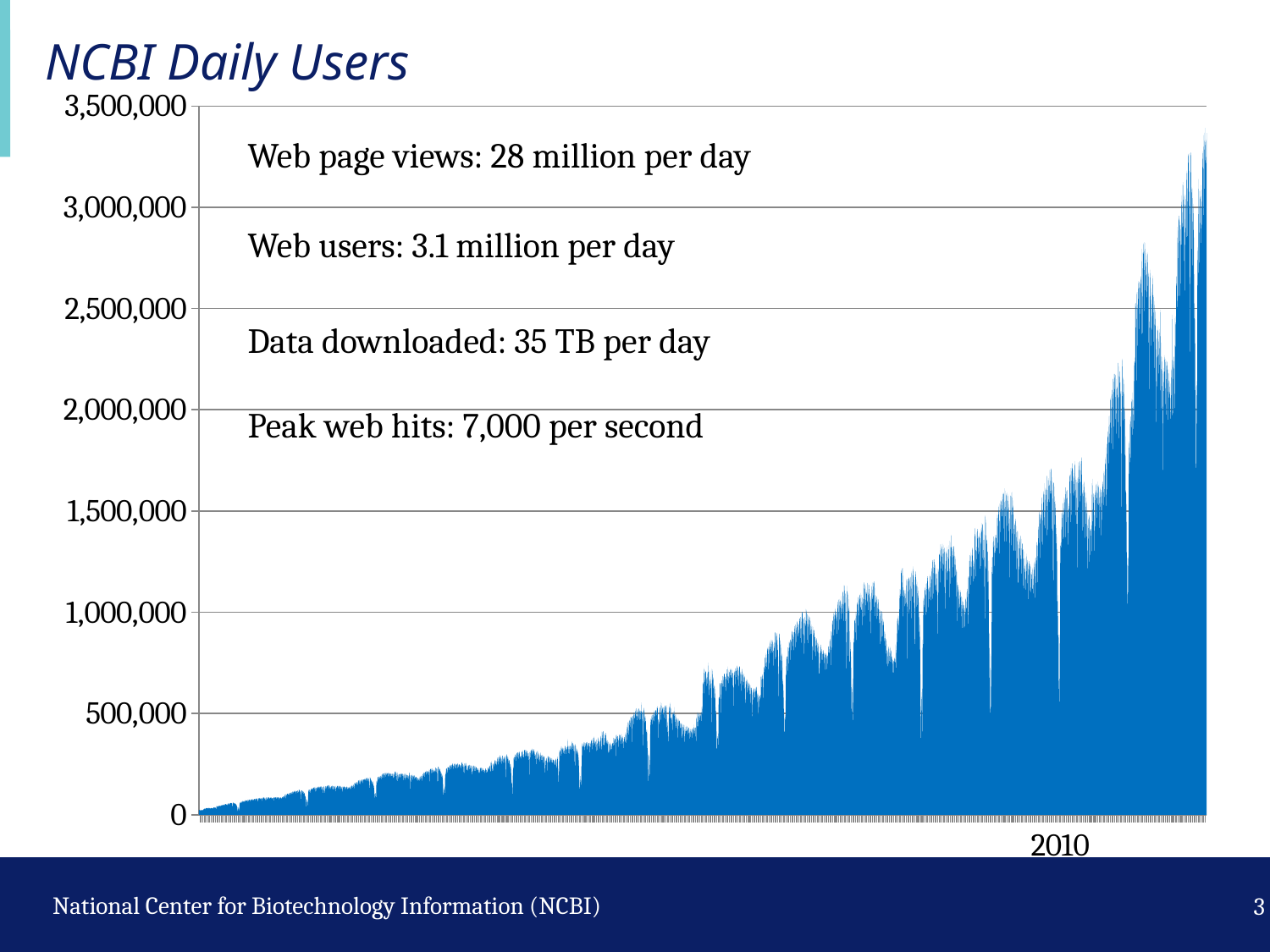
Is the highest value reached in the chart greater or less than 3,000,000? greater Where along the x axis does the chart reach its highest value? at the far right end What is the title of the chart? NCBI Daily Users What kind of chart is shown on the slide? area chart Is the value at the far left (start) of the chart greater or less than 500,000? less Where along the x axis does the chart have its lowest values? at the far left end Does the chart ever exceed the top axis value of 3,500,000? no Do the values in the chart generally rise or fall from left to right along the x axis? rise What is the highest value labelled on the y axis? 3,500,000